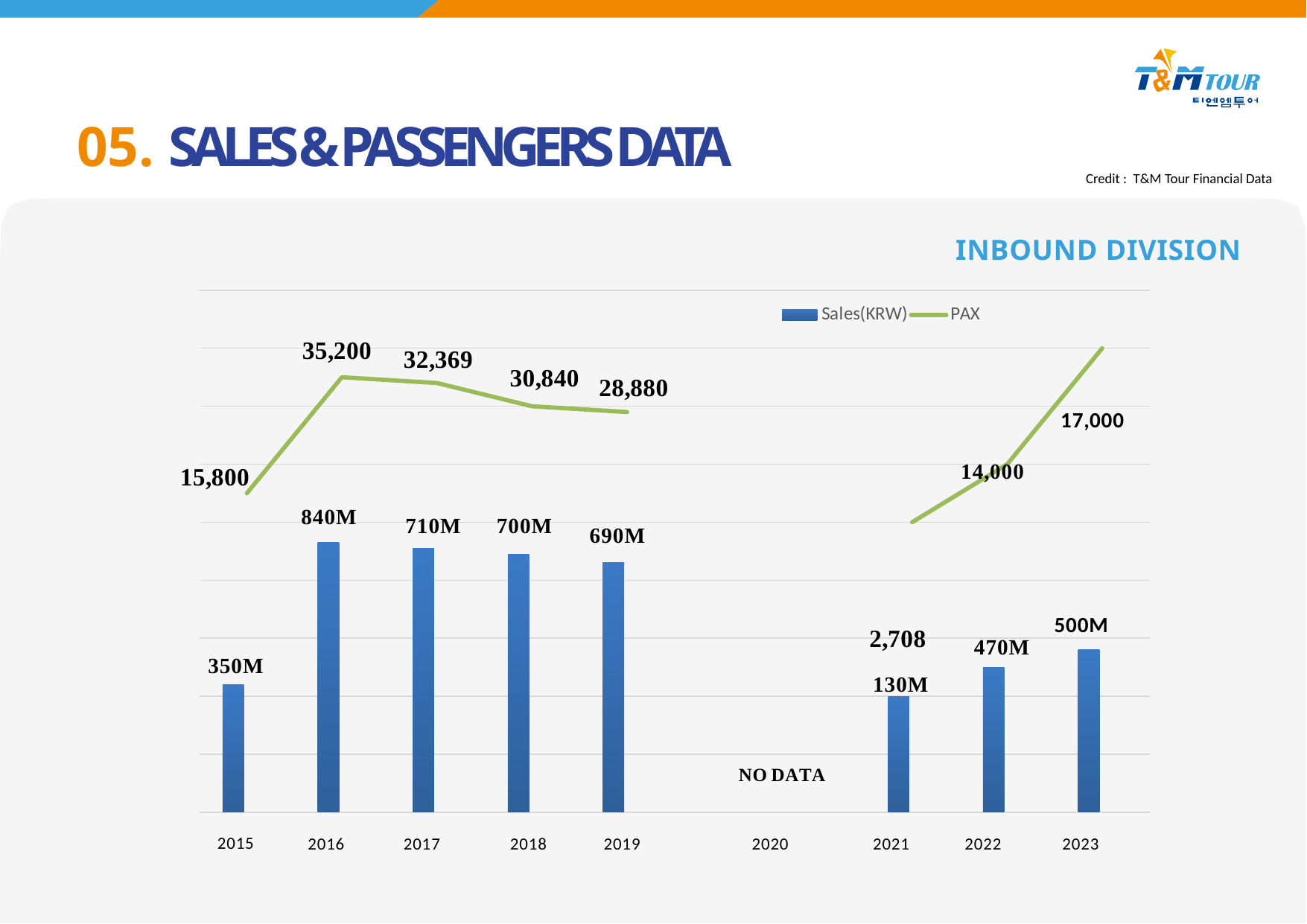
Which year has the highest Sales(KRW)? 2016 What is the Sales(KRW) value for 2016? 840M Which series is drawn as a line in the chart? PAX Which year on the x axis is marked as NO DATA? 2020 What is the difference in PAX between 2016 and 2015? 19,400 How many series does the legend list? 2 Which year has the lowest PAX value shown? 2021 How do the PAX values change from 2016 to 2019? They fall What is the difference in Sales(KRW) between 2023 and 2021? 370M Which year has higher Sales(KRW), 2022 or 2023? 2023 What is the PAX value for 2017? 32,369 What is the PAX value for 2021? 2,708